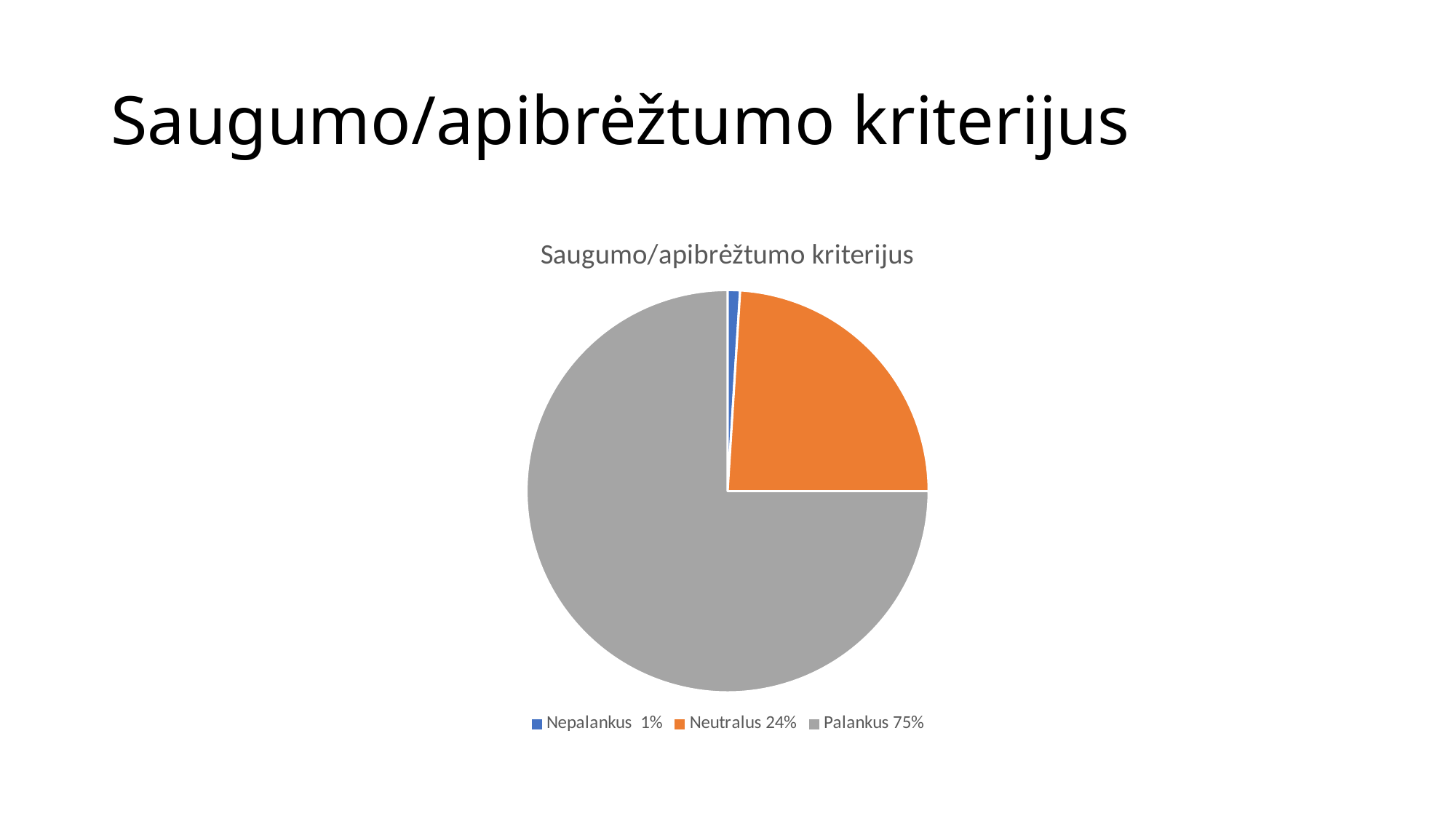
What share of the pie is Nepalankus? 1% What is the difference in percentage points between Palankus and Neutralus? 51 Which category has the smallest slice? Nepalankus What kind of chart is shown on the slide? pie chart What share of the pie is Neutralus? 24% Which is larger, Neutralus or Nepalankus? Neutralus What is the title of the chart? Saugumo/apibrėžtumo kriterijus Which category has the largest slice? Palankus What colour is the Neutralus slice? orange How many slices does the pie chart have? 3 What is the difference in percentage points between Neutralus and Nepalankus? 23 What share of the pie is Palankus? 75%